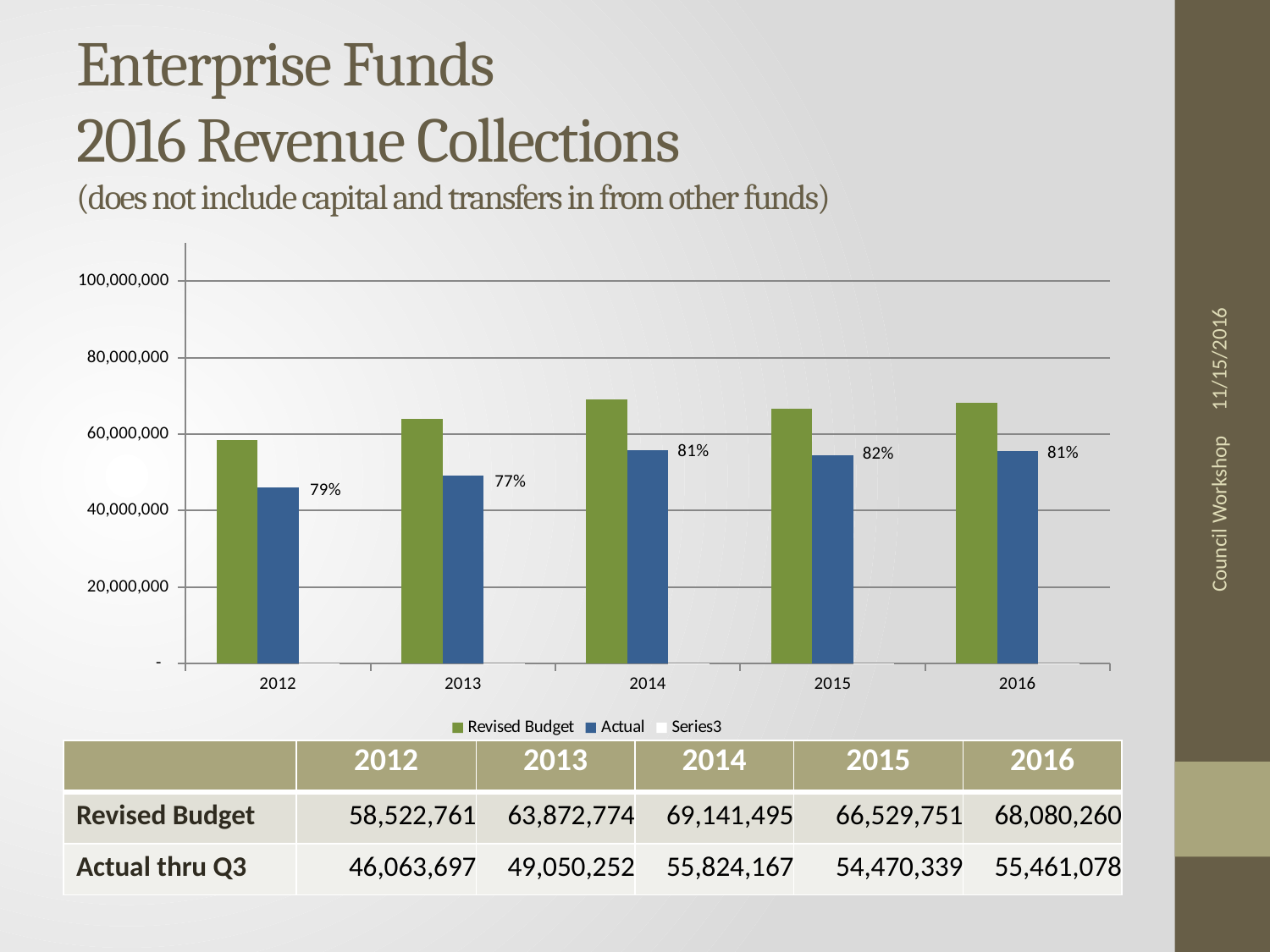
What type of chart is shown on the slide? bar chart How many series does the chart legend list? 3 Which is larger, the Revised Budget for 2013 or the Revised Budget for 2015? Revised Budget for 2015 Which year has the highest Revised Budget? 2014 Is the Actual value for 2012 greater or less than 60,000,000? less Which year has the lowest Actual value? 2012 What is the difference between the Revised Budget and the Actual thru Q3 value for 2012? 12,459,064 How many years are shown on the x axis of the chart? 5 Which series is shown in green in the chart? Revised Budget What is the Revised Budget value for 2014? 69,141,495 What percentage label is shown on the Actual bar for 2015? 82% What is the Actual thru Q3 value for 2016? 55,461,078